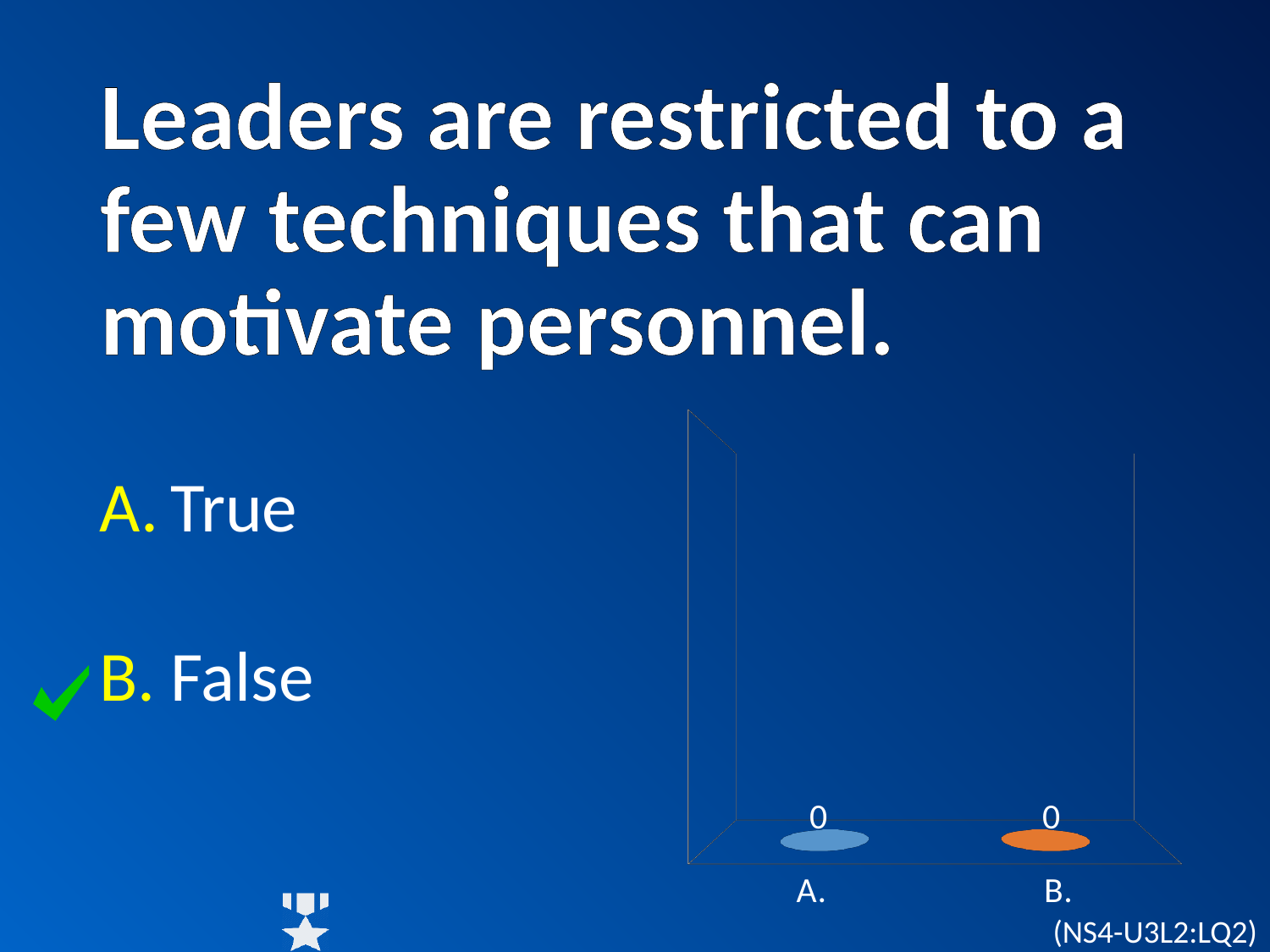
Are the values for A. and B. on the chart equal, or is one larger? equal Do the values rise, fall, or stay the same from A. to B. on the chart? stay the same What colour is the bar for category B. on the chart? orange What type of chart is shown on the slide? bar chart What is the value shown for category B. on the chart? 0 What are the category labels on the chart's x axis? A. and B. How many categories are shown on the chart's x axis? 2 What is the value shown for category A. on the chart? 0 What is the difference between the values for A. and B. on the chart? 0